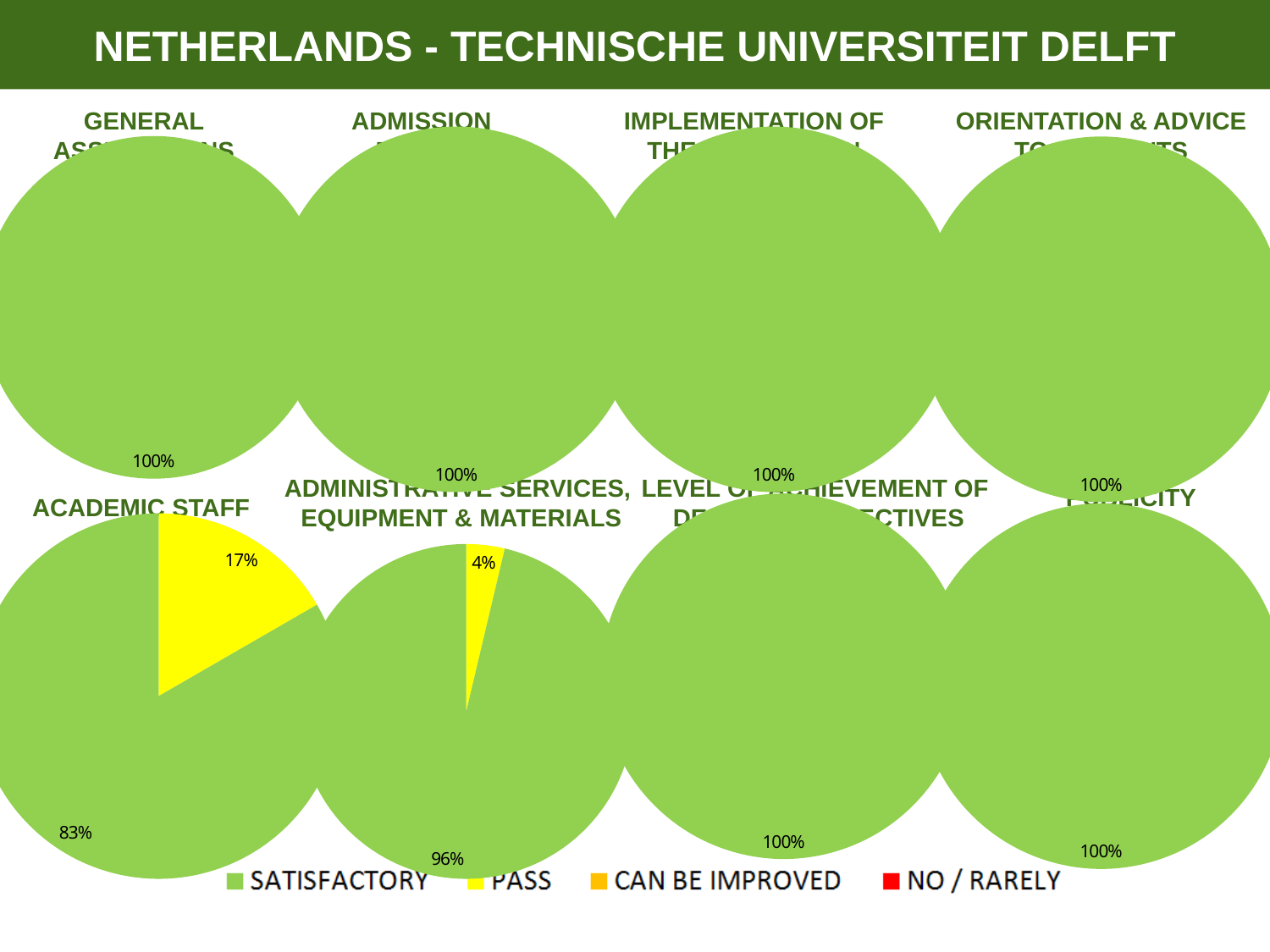
In the ADMINISTRATIVE SERVICES, EQUIPMENT & MATERIALS pie chart, what share is labelled for the SATISFACTORY slice? 96% In the ACADEMIC STAFF pie chart, what share is labelled for the PASS slice? 17% In the ACADEMIC STAFF pie chart, what is the difference in percentage points between the SATISFACTORY and PASS slices? 66 percentage points In the ACADEMIC STAFF pie chart, what share is labelled for the SATISFACTORY slice? 83% How many pie charts are shown on the slide? 8 Which pie chart on the slide has the largest PASS slice? ACADEMIC STAFF How many entries does the shared legend at the bottom of the slide list? 4 What kind of charts are shown on the slide? Pie charts According to the legend, which colour represents SATISFACTORY? Green In the ACADEMIC STAFF pie chart, which slice is larger, SATISFACTORY or PASS? SATISFACTORY